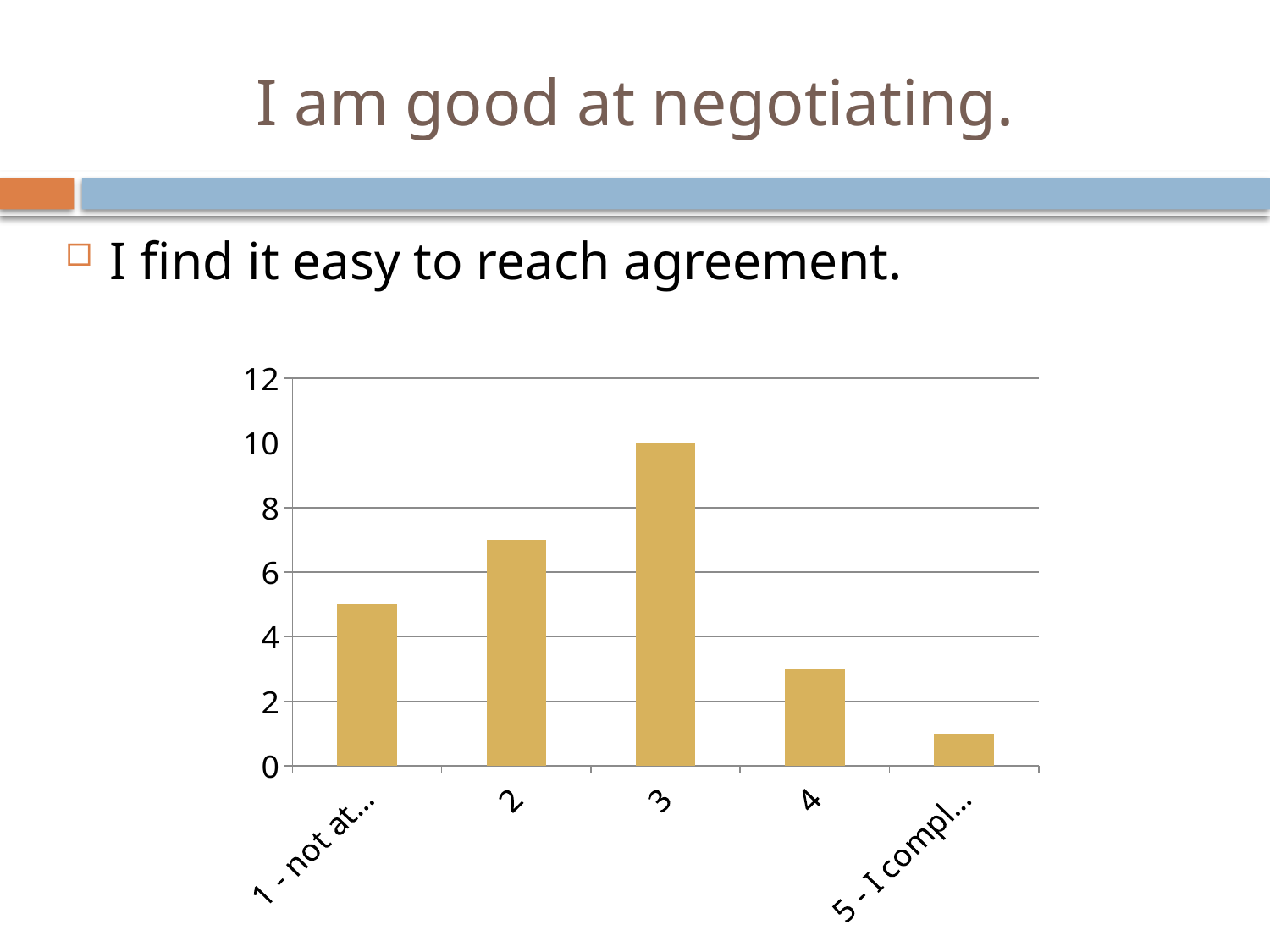
Is the value for category 2 greater or less than 6? greater What is the title of the slide containing the chart? I am good at negotiating. Is the value for the category labelled "1 - not at..." greater or less than 4? greater Is the value for the rightmost category greater or less than 2? less Do the values rise or fall from category 3 to category 5? fall How many categories are shown on the x axis of the chart? 5 Which category has the lowest value? 5 - I compl... Which has the larger value, category 2 or category 4? 2 What is the value for category 3? 10 Which category has the highest value? 3 What type of chart is shown on the slide? bar chart